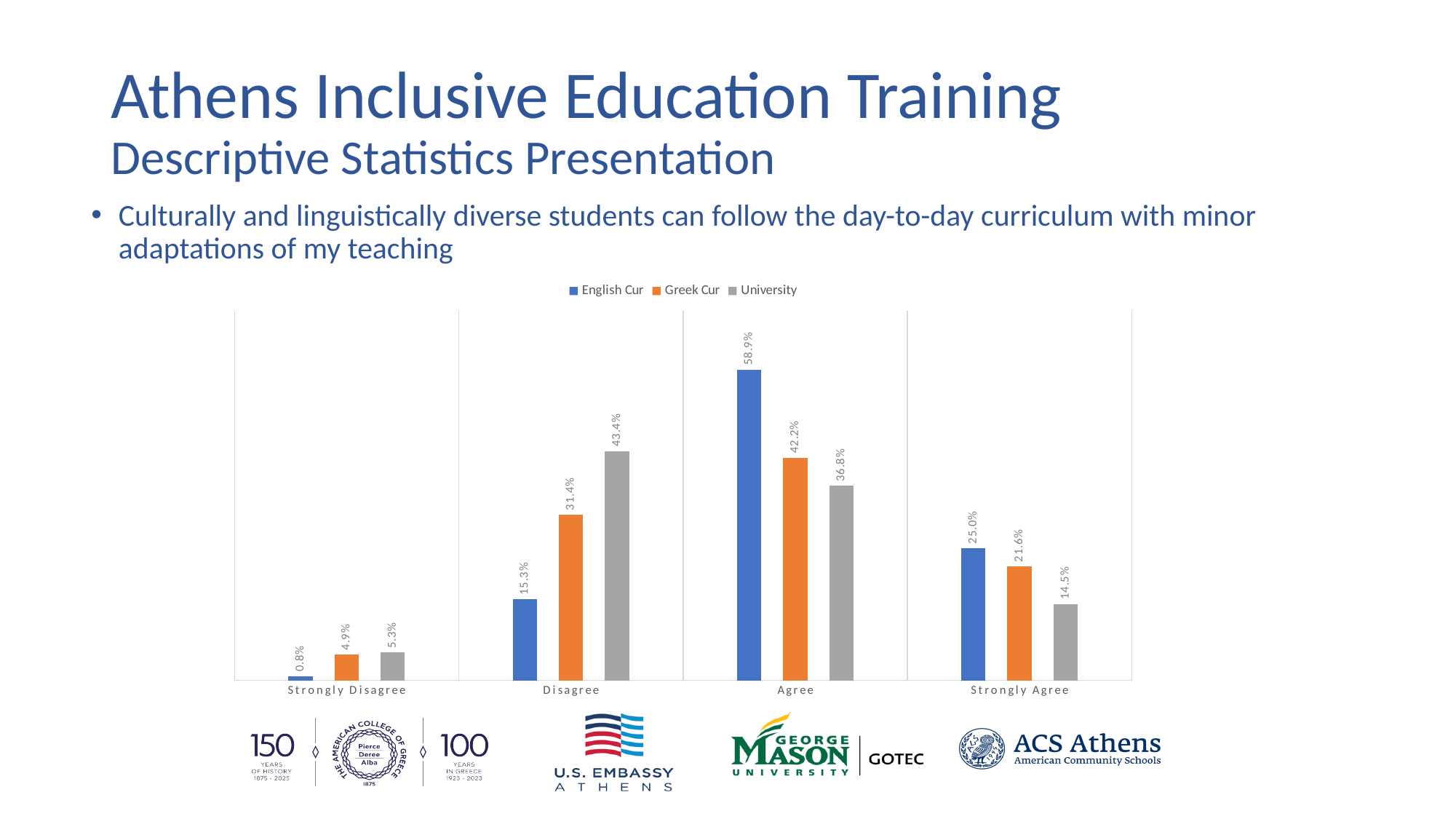
Which category has the lowest value for the University series? Strongly Disagree What is the value for University in the Disagree category? 43.4% How many categories are shown on the x axis? 4 What is the value for Greek Cur in the Strongly Agree category? 21.6% Which category has the highest value for the English Cur series? Agree What is the difference between the English Cur and Greek Cur values in the Agree category? 16.7% What is the value for English Cur in the Agree category? 58.9% Which series is shown in orange in the legend? Greek Cur What kind of chart is shown on the slide? Bar chart How many series does the legend list? 3 In the Disagree category, which series has the larger value: Greek Cur or University? University What is the value for English Cur in the Strongly Disagree category? 0.8%